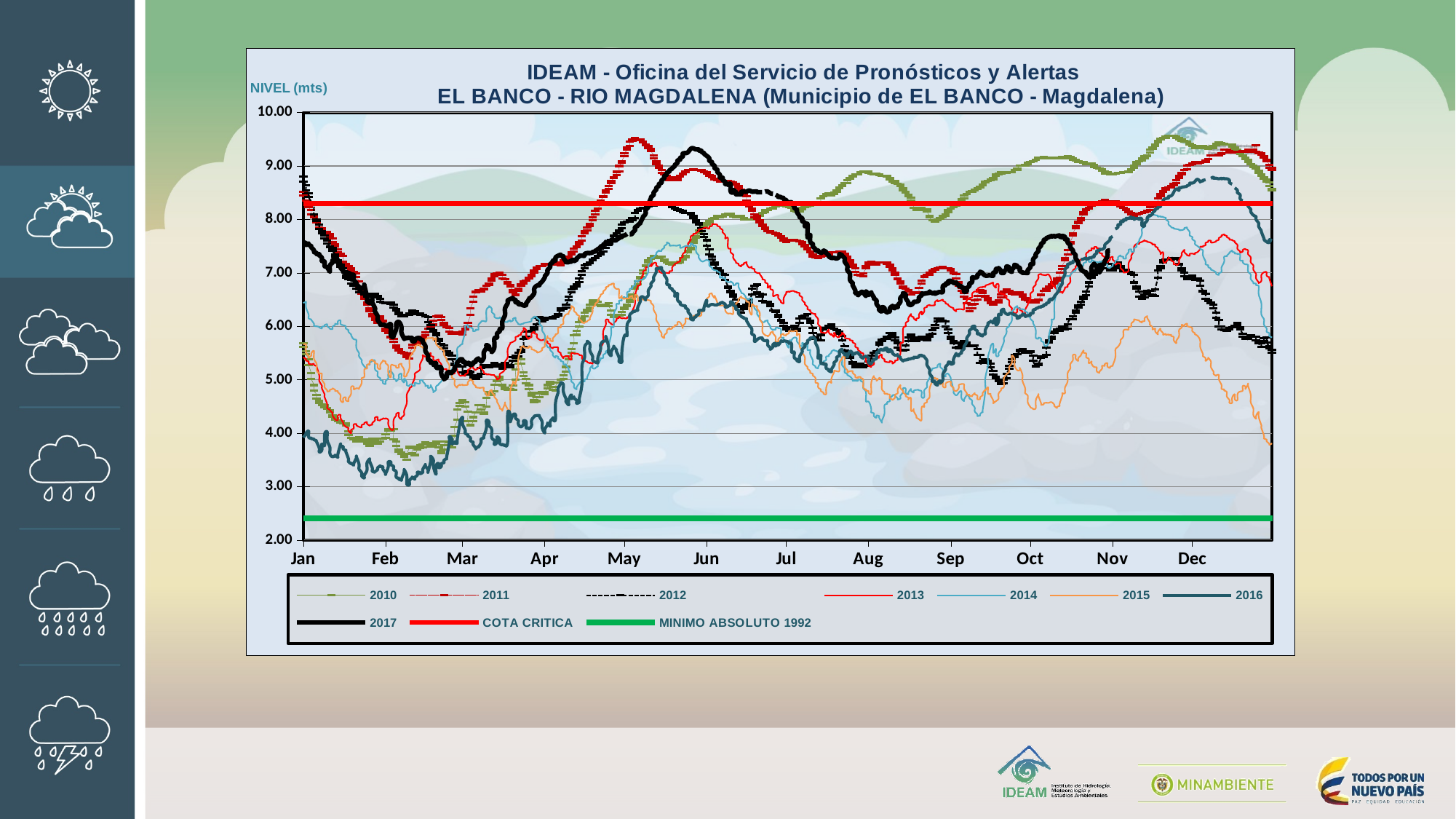
Is the value of the 2010 series in Oct greater or less than 8.00? greater What kind of chart is shown on the slide? line chart In Oct, which series is higher, 2010 or 2015? 2010 What is the label of the y axis? NIVEL (mts) How many months are labelled along the x axis? 12 Is the MINIMO ABSOLUTO 1992 line greater or less than 3.00? less Is the value of the 2016 series in Feb greater or less than 4.00? less What colour is the COTA CRITICA line? red Which is higher, the COTA CRITICA line or the MINIMO ABSOLUTO 1992 line? COTA CRITICA How many series does the legend list? 10